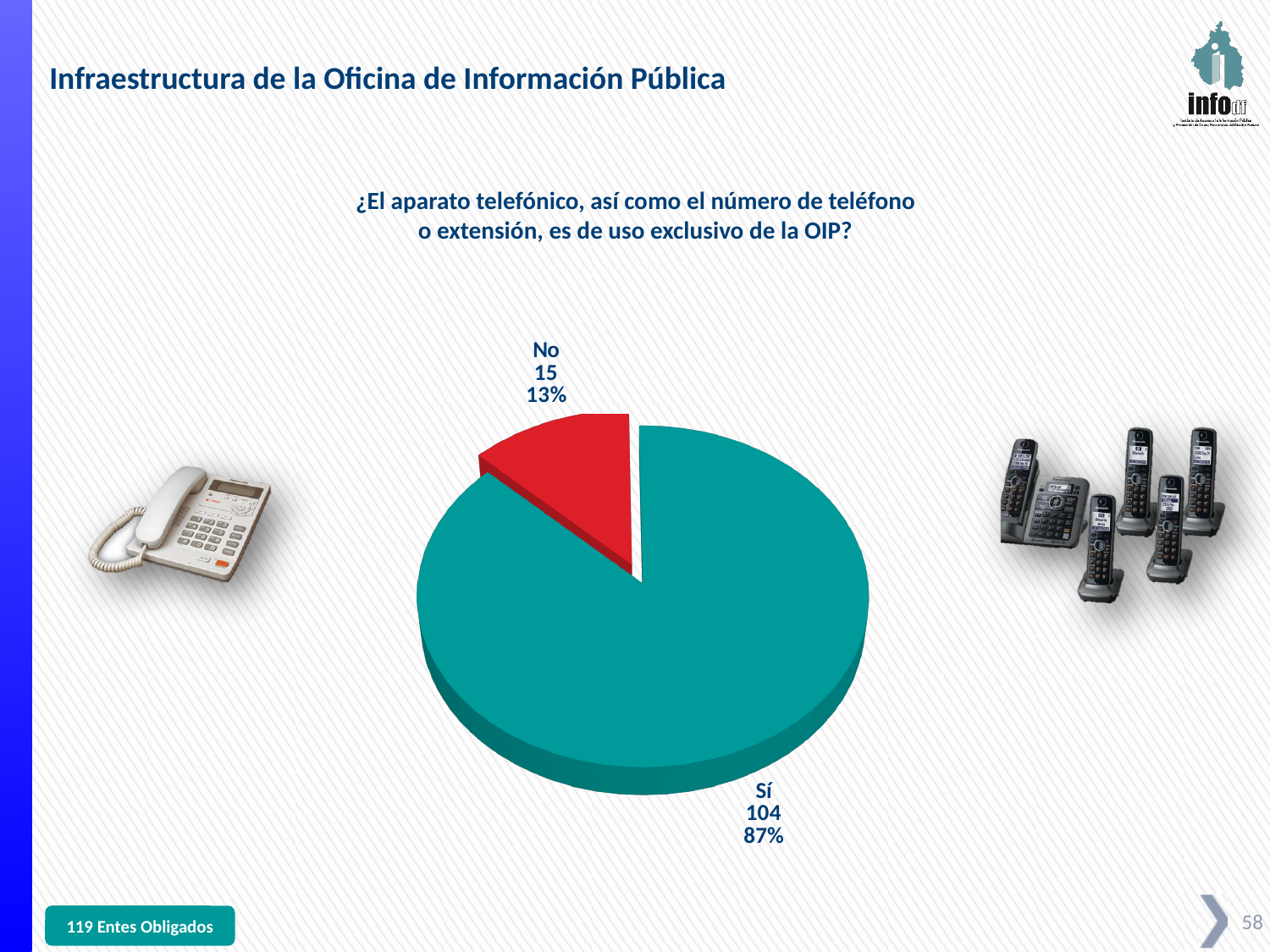
What is the total of the two slices in the pie chart? 119 Which category has the smallest slice? No How many categories does the pie chart have? 2 What percentage of the pie does the "No" slice represent? 13% What is the difference between the number of "Sí" and "No" responses? 89 What kind of chart is shown on the slide? pie chart Which category has the largest slice? Sí What colour is the "No" slice? red How many entities answered "No"? 15 What percentage of the pie does the "Sí" slice represent? 87% Which is larger, the "Sí" count or the "No" count? Sí How many entities answered "Sí"? 104